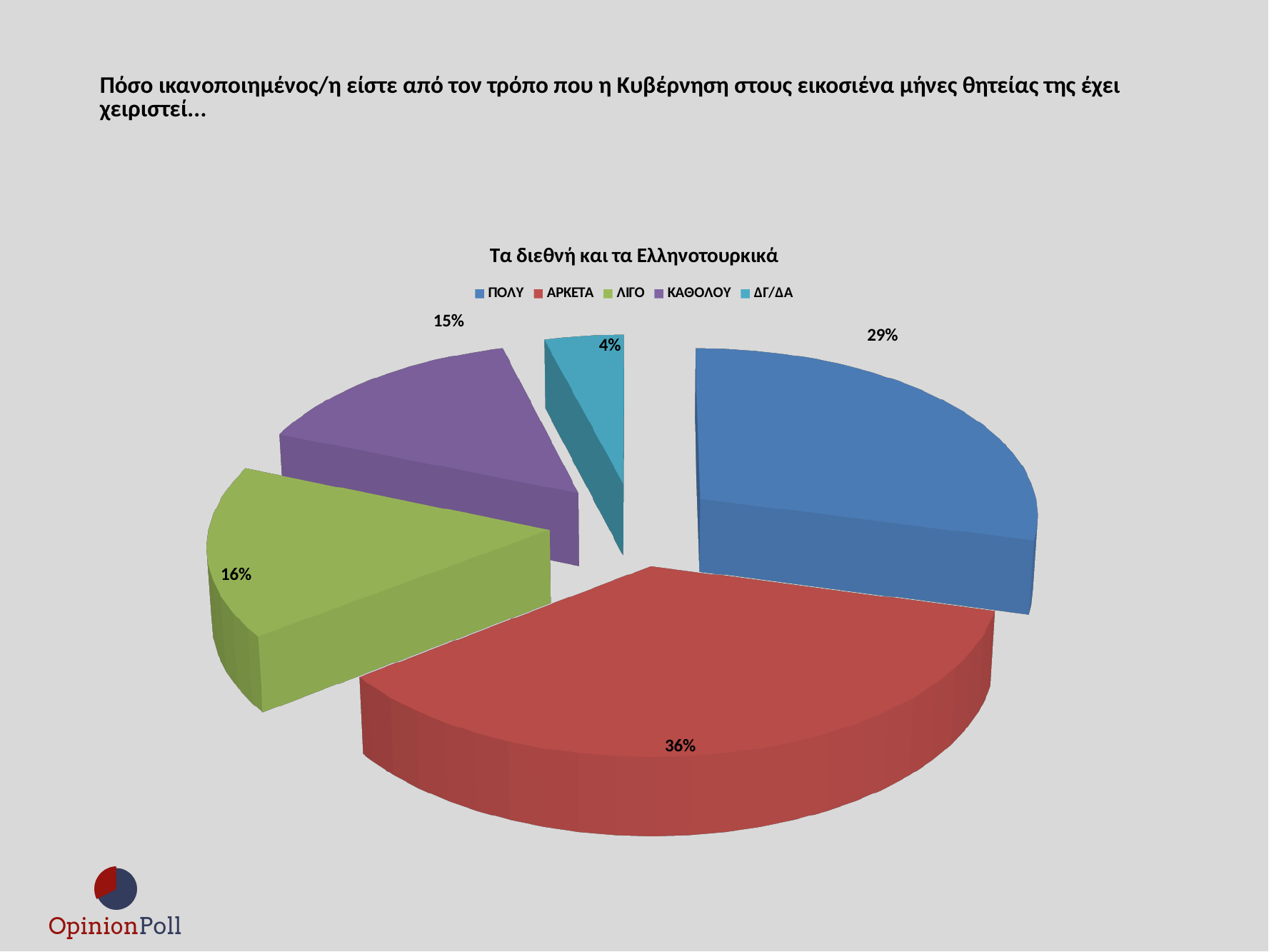
What percentage of respondents answered ΛΙΓΟ? 16% Which is larger, the share for ΠΟΛΥ or the share for ΛΙΓΟ? ΠΟΛΥ What is the difference in percentage points between ΑΡΚΕΤΑ and ΠΟΛΥ? 7 What type of chart is shown on the slide? Pie chart What percentage of respondents answered ΚΑΘΟΛΟΥ? 15% Which response has the largest share of the pie? ΑΡΚΕΤΑ What percentage of respondents answered ΠΟΛΥ? 29% Which response has the smallest share of the pie? ΔΓ/ΔΑ What is the title of the chart? Τα διεθνή και τα Ελληνοτουρκικά How many slices does the pie chart have? 5 What percentage of respondents answered ΔΓ/ΔΑ? 4% What percentage of respondents answered ΑΡΚΕΤΑ? 36%